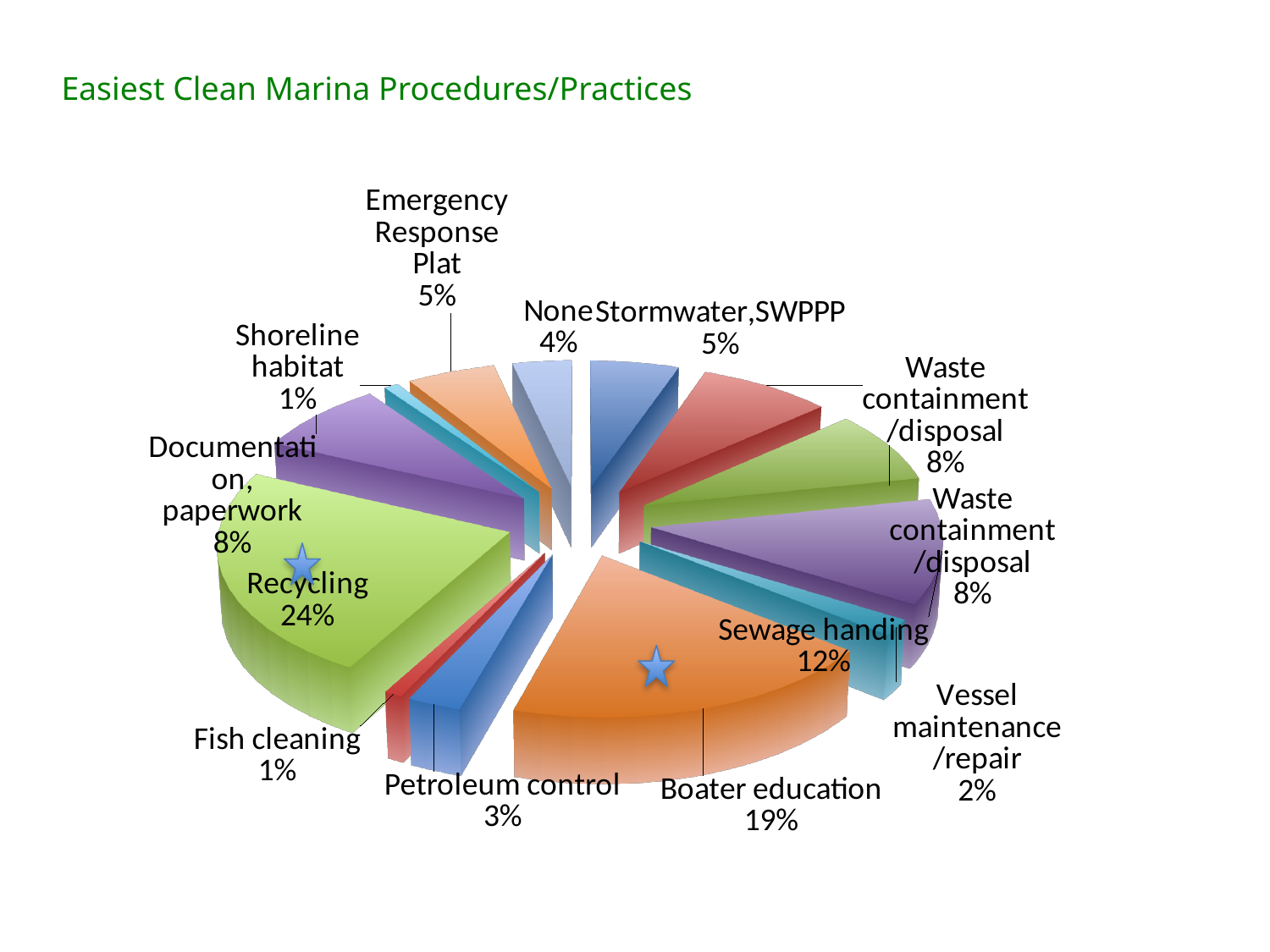
What percentage is shown for Sewage handing? 12% Which category has the largest share of the pie? Recycling Which has a larger share, Sewage handing or Documentation, paperwork? Sewage handing How many slices does the pie chart have? 13 What share of the pie does Recycling have? 24% What is the title of the chart? Easiest Clean Marina Procedures/Practices What percentage is shown for Vessel maintenance/repair? 2% What kind of chart is shown on the slide? pie chart What percentage is shown for Petroleum control? 3% Which has a larger share, Emergency Response Plat or None? Emergency Response Plat What is the difference in percentage points between Recycling and Boater education? 5 What share of the pie does Boater education have? 19%